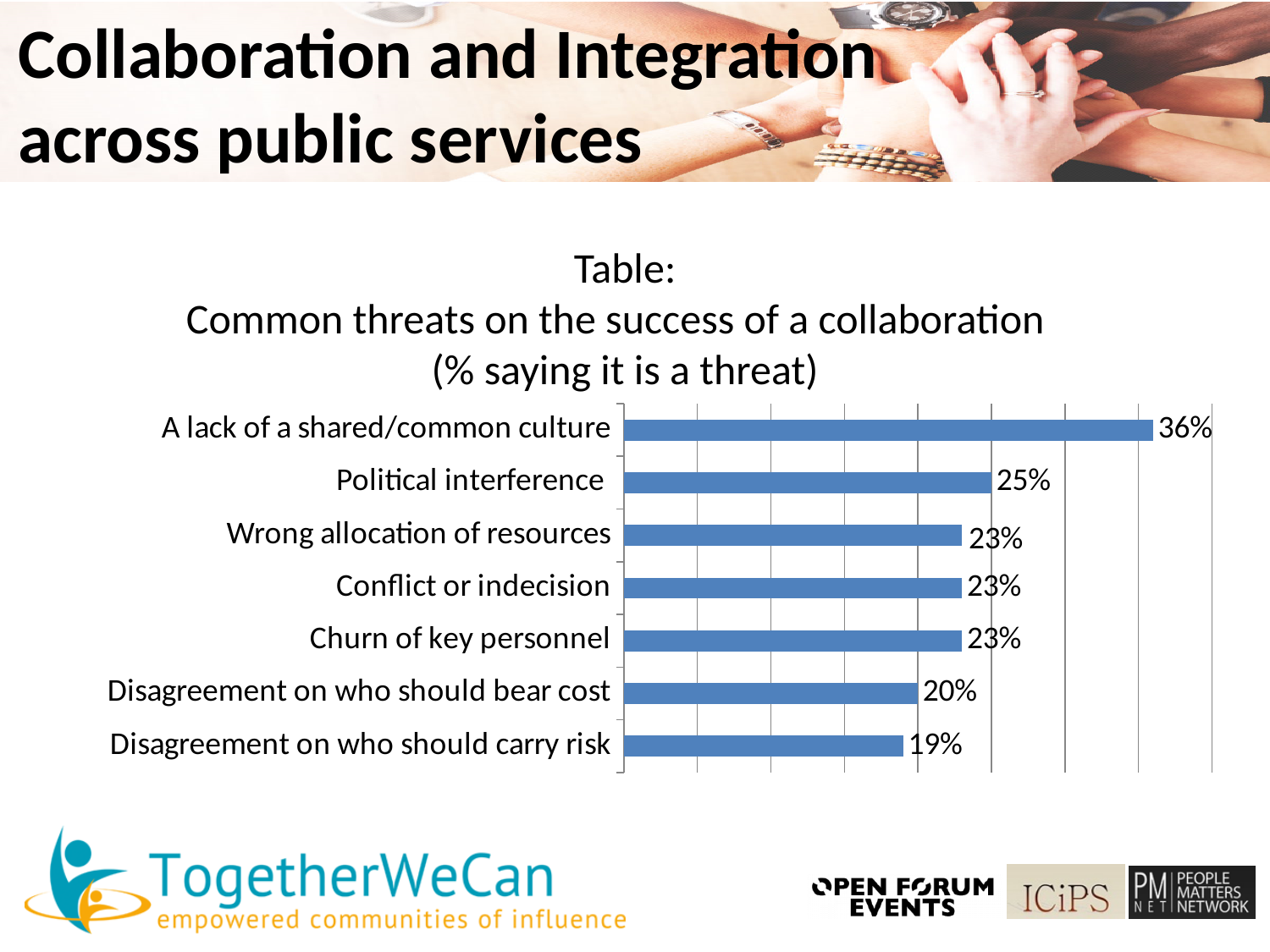
What is the value for Disagreement on who should bear cost? 20% What is the difference between the values for Disagreement on who should bear cost and Disagreement on who should carry risk? 1% What is the value for Disagreement on who should carry risk? 19% Which threat has the highest percentage? A lack of a shared/common culture Which is larger, the value for Political interference or the value for Churn of key personnel? Political interference What is the difference between the values for A lack of a shared/common culture and Political interference? 11% How many threats are listed in the chart? 7 What is the value for Political interference? 25% Which threat has the lowest percentage? Disagreement on who should carry risk What kind of chart is shown on the slide? Bar chart What percentage of respondents said a lack of a shared/common culture is a threat? 36% How many categories share the value 23%? 3